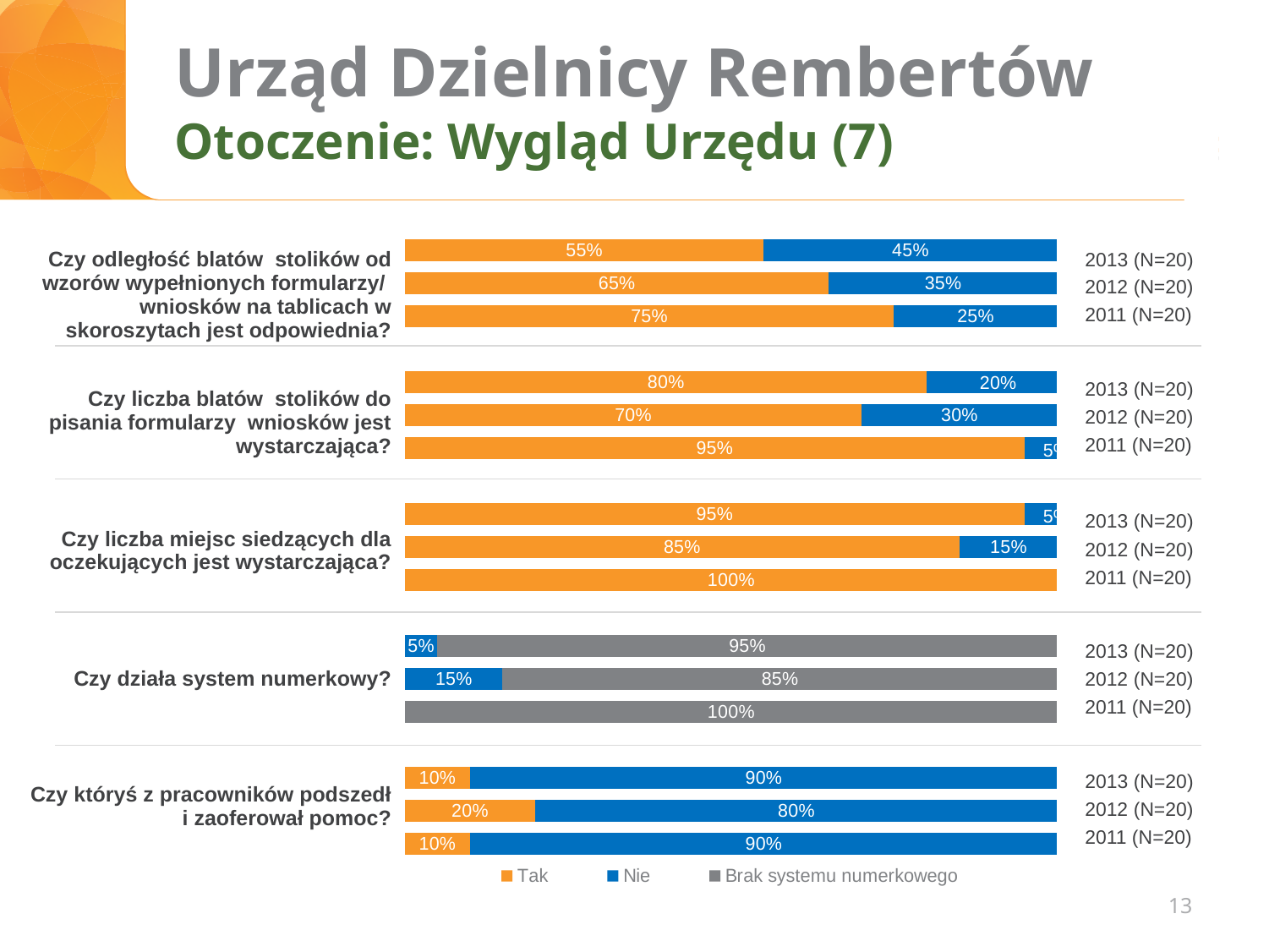
In the chart for "Czy liczba blatów stolików do pisania formularzy wniosków jest wystarczająca?", what percentage answered "Tak" in 2012 (N=20)? 70% In the chart for "Czy liczba miejsc siedzących dla oczekujących jest wystarczająca?", what is the difference between the "Tak" share in 2013 (N=20) and in 2012 (N=20)? 10% What kind of chart is used on this slide? Stacked bar chart In the chart for "Czy odległość blatów stolików od wzorów wypełnionych formularzy/wniosków na tablicach w skoroszytach jest odpowiednia?", what percentage answered "Nie" in 2011 (N=20)? 25% In the chart for "Czy któryś z pracowników podszedł i zaoferował pomoc?", what percentage answered "Nie" in 2012 (N=20)? 80% In the chart for "Czy liczba miejsc siedzących dla oczekujących jest wystarczająca?", what percentage answered "Tak" in 2011 (N=20)? 100% In the chart for "Czy liczba blatów stolików do pisania formularzy wniosków jest wystarczająca?", which year has the highest "Tak" share? 2011 (N=20) How many series does the legend at the bottom of the slide list? 3 In the chart for "Czy odległość blatów stolików od wzorów wypełnionych formularzy/wniosków na tablicach w skoroszytach jest odpowiednia?", what percentage answered "Tak" in 2013 (N=20)? 55% In the chart for "Czy działa system numerkowy?", what percentage answered "Brak systemu numerkowego" in 2012 (N=20)? 85% In the chart for "Czy któryś z pracowników podszedł i zaoferował pomoc?", is the "Tak" share in 2012 (N=20) larger or smaller than in 2013 (N=20)? larger